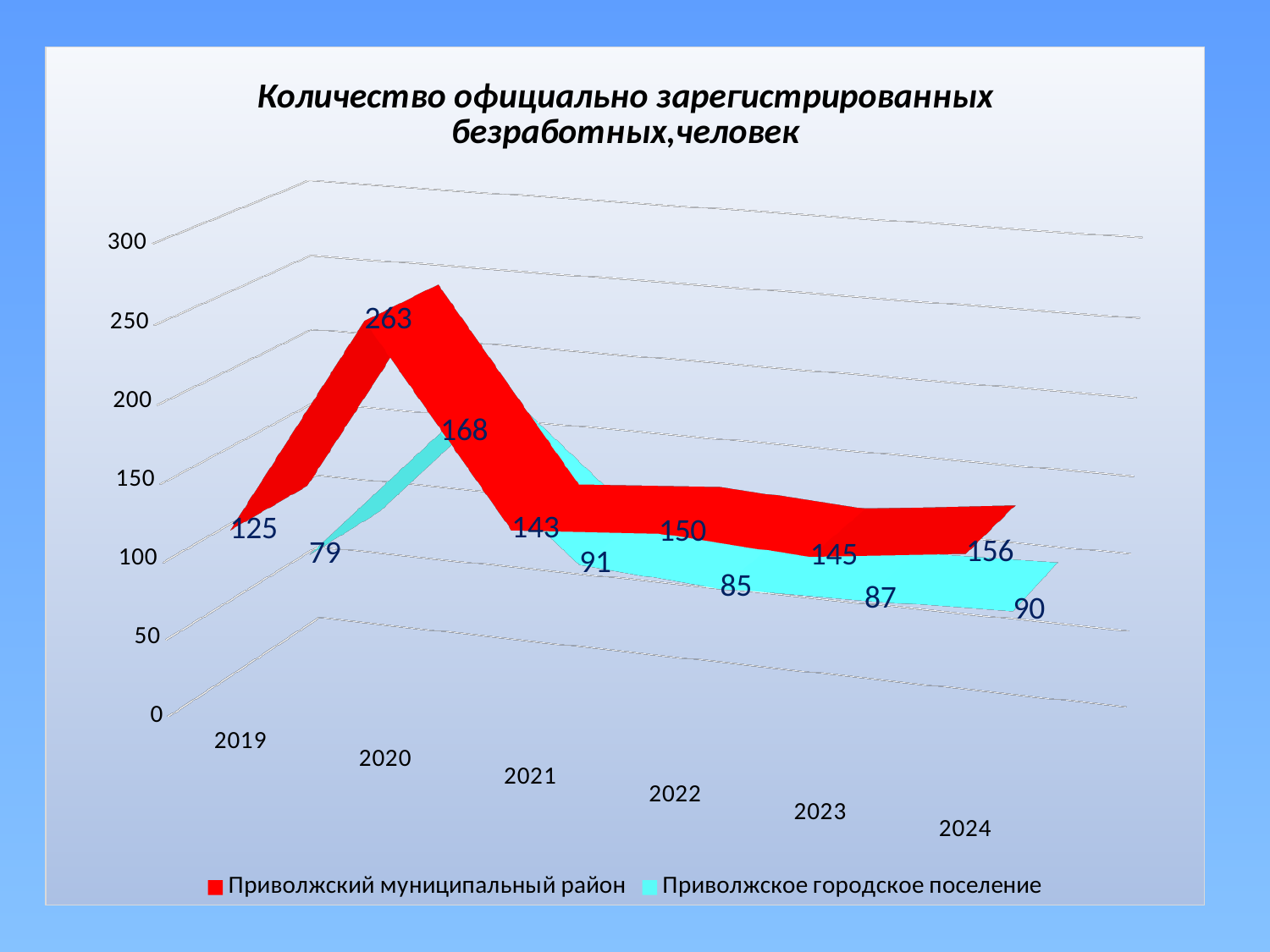
In which year is the value for Приволжское городское поселение lowest? 2019 In which year is the value for Приволжский муниципальный район highest? 2020 How many series does the legend list? 2 What is the difference between the two series in 2020? 95 What is the value for Приволжский муниципальный район in 2020? 263 What is the value for Приволжское городское поселение in 2024? 90 Does the value for Приволжский муниципальный район rise or fall from 2020 to 2021? fall What kind of chart is this? line chart What is the difference between the 2024 and 2023 values for Приволжский муниципальный район? 11 What is the value for Приволжское городское поселение in 2019? 79 How many years are shown on the x axis? 6 Which is larger: the 2022 value for Приволжский муниципальный район or the 2021 value for Приволжское городское поселение? 2022 value for Приволжский муниципальный район